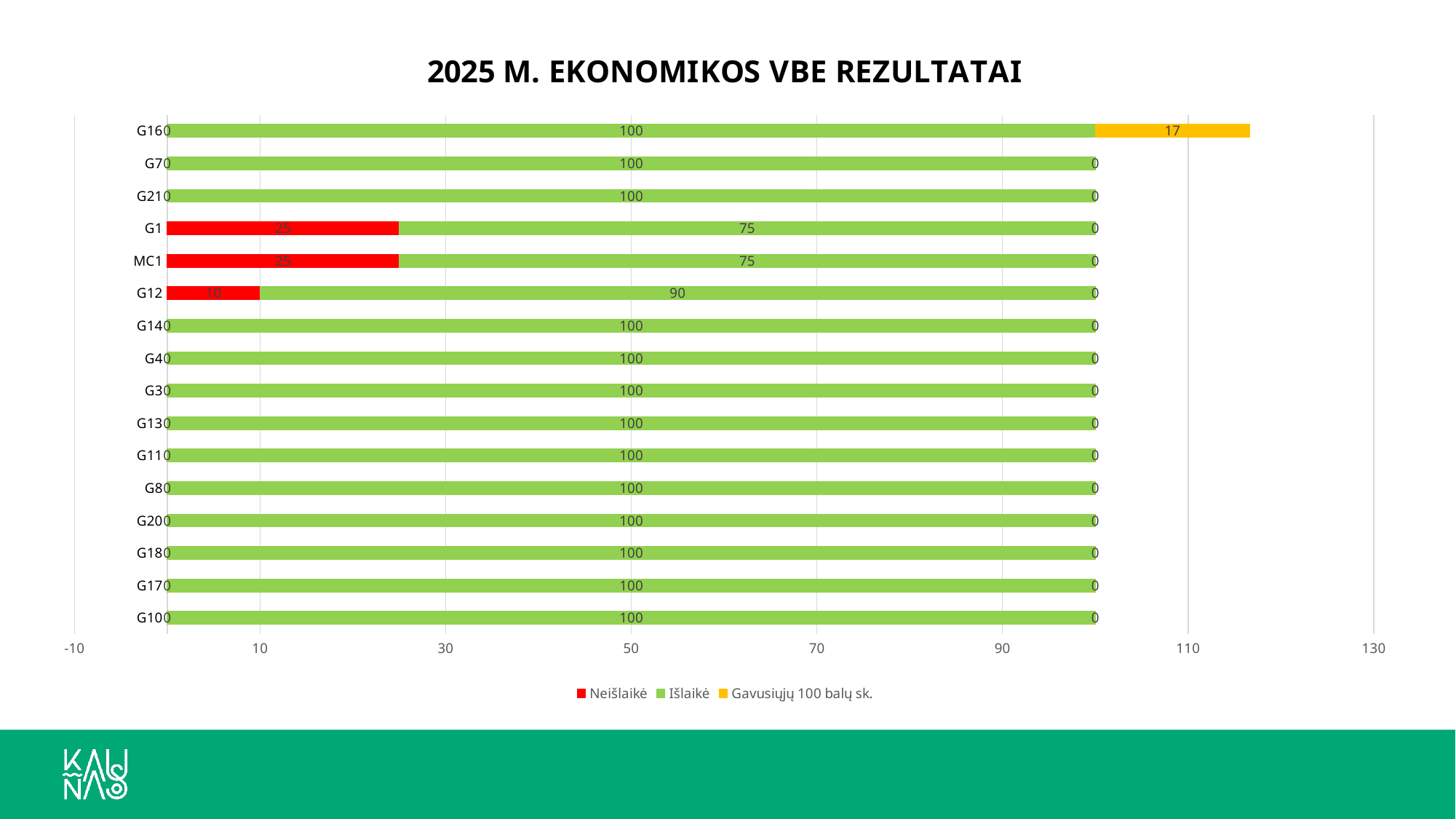
Which is larger, the Neišlaikė value for G12 or the Neišlaikė value for MC1? MC1 What is the difference between the Išlaikė values for G12 and G1? 15 What is the Išlaikė value for MC1? 75 What is the Gavusiųjų 100 balų sk. value for G160? 17 How many categories are shown on the chart? 16 What is the Neišlaikė value for G12? 10 How many series does the legend list? 3 Which category has the highest Neišlaikė value? G1 and MC1 What is the Neišlaikė value for G1? 25 What is the title of the chart? 2025 M. EKONOMIKOS VBE REZULTATAI What type of chart is shown on the slide? bar chart What is the total of the stacked bar for G160? 117